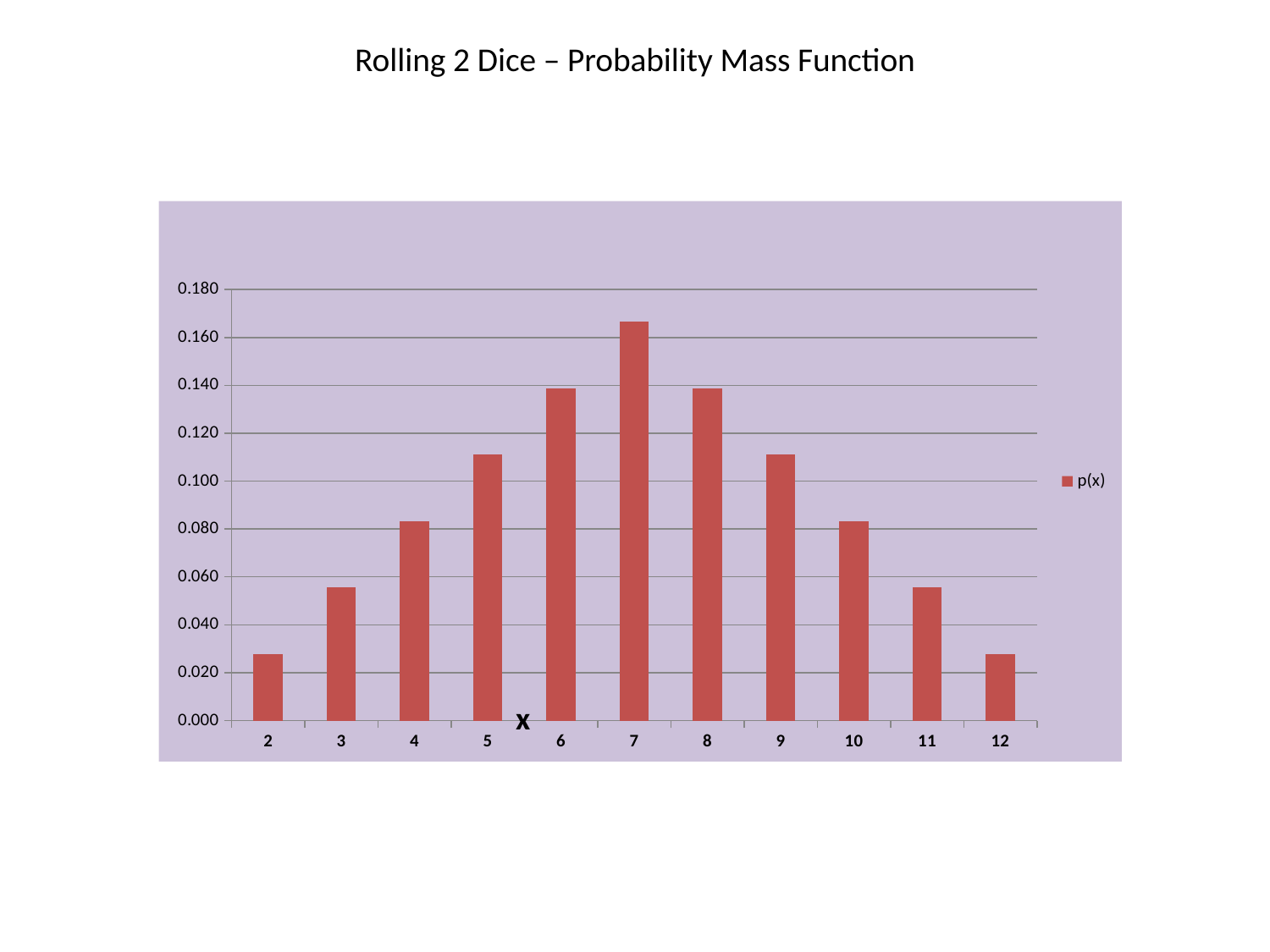
How many x categories are plotted on the chart? 11 Is the value of p(x) for x = 12 greater or less than 0.040? less How many series does the legend list? 1 Which value of x has the highest p(x)? 7 How do the p(x) values change as x increases from 2 to 12? rise up to 7, then fall Which has a larger p(x): x = 7 or x = 2? 7 What kind of chart is shown on the slide? bar chart Is the value of p(x) for x = 8 greater or less than 0.120? greater Is the value of p(x) for x = 9 greater or less than 0.100? greater What is the name of the series shown in the legend? p(x)